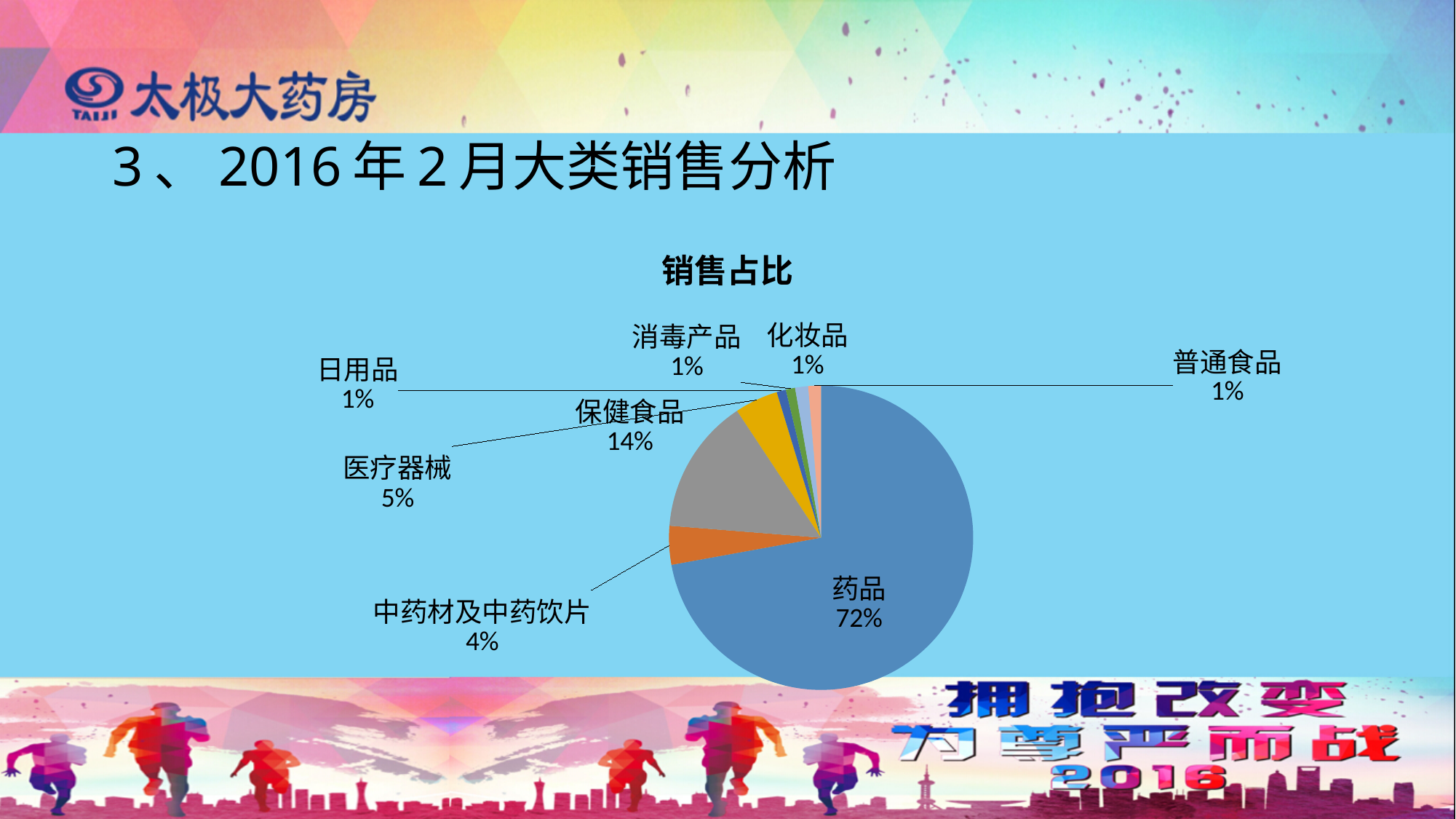
Which has a larger share, 医疗器械 or 中药材及中药饮片? 医疗器械 Which category has the largest share of the pie? 药品 What kind of chart is shown on the slide? pie chart What share of sales does 日用品 account for? 1% What share of sales does 中药材及中药饮片 account for? 4% What is the difference in share between 药品 and 保健食品? 58% What share of sales does 药品 account for? 72% What share of sales does 保健食品 account for? 14% What is the title of the chart? 销售占比 What share of sales does 医疗器械 account for? 5% What is the combined share of 保健食品 and 医疗器械? 19% How many categories are shown in the pie chart? 8